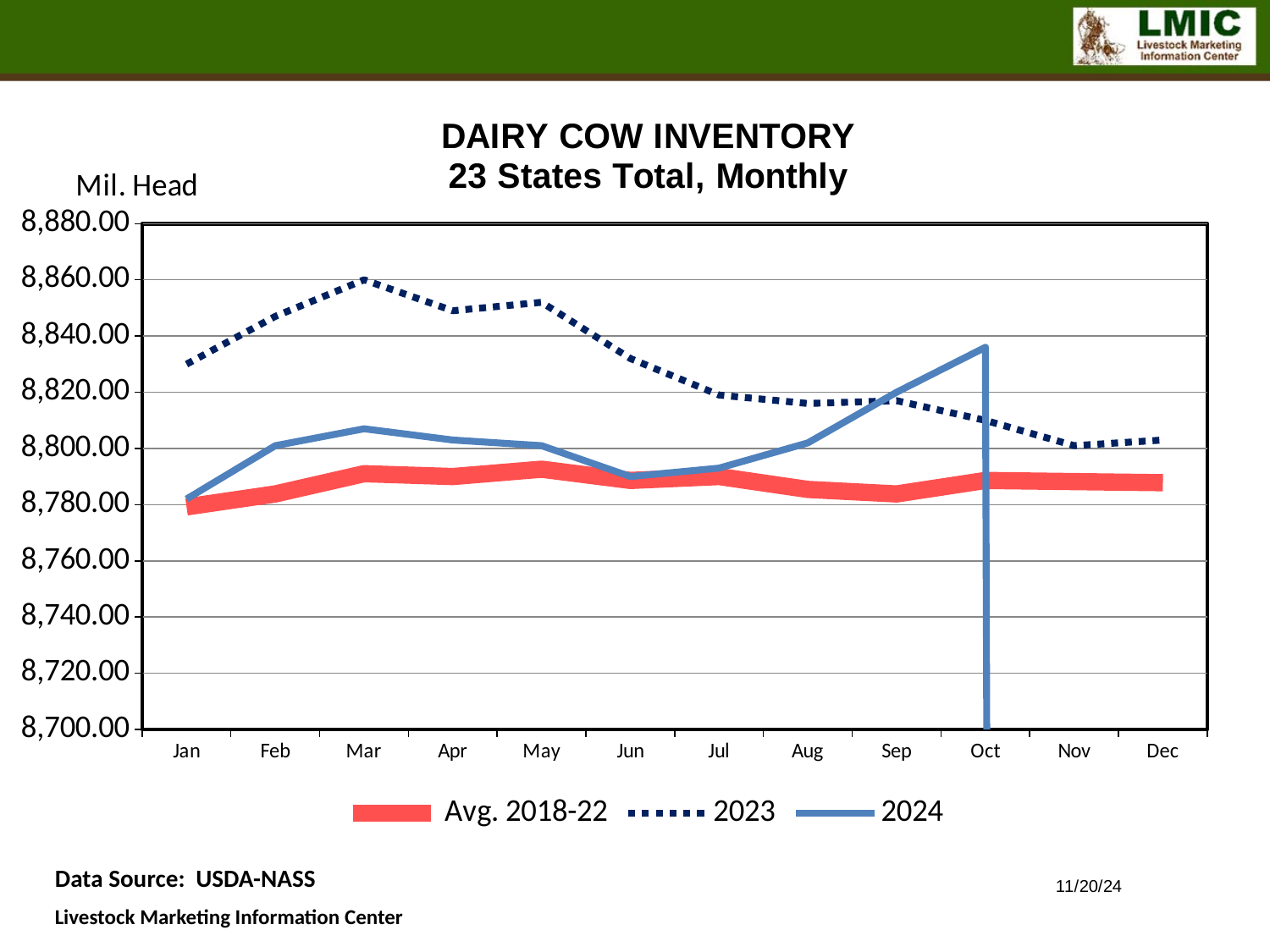
Is the 2023 value for Mar greater or less than 8,840.00? greater What unit label is shown above the y axis? Mil. Head Is the 2024 value for Jan greater or less than 8,800.00? less What kind of chart is shown on the slide? line chart In which month does the 2024 series reach its highest value? Oct In Mar, which series has the larger value, 2023 or 2024? 2023 Is the 2024 value for Oct greater or less than 8,820.00? greater In which month is the 2024 series at its lowest value? Jan How many months are shown along the x axis? 12 In which month does the 2023 series reach its highest value? Mar How many series does the legend list? 3 Does the 2023 series rise or fall from Mar to Nov? fall